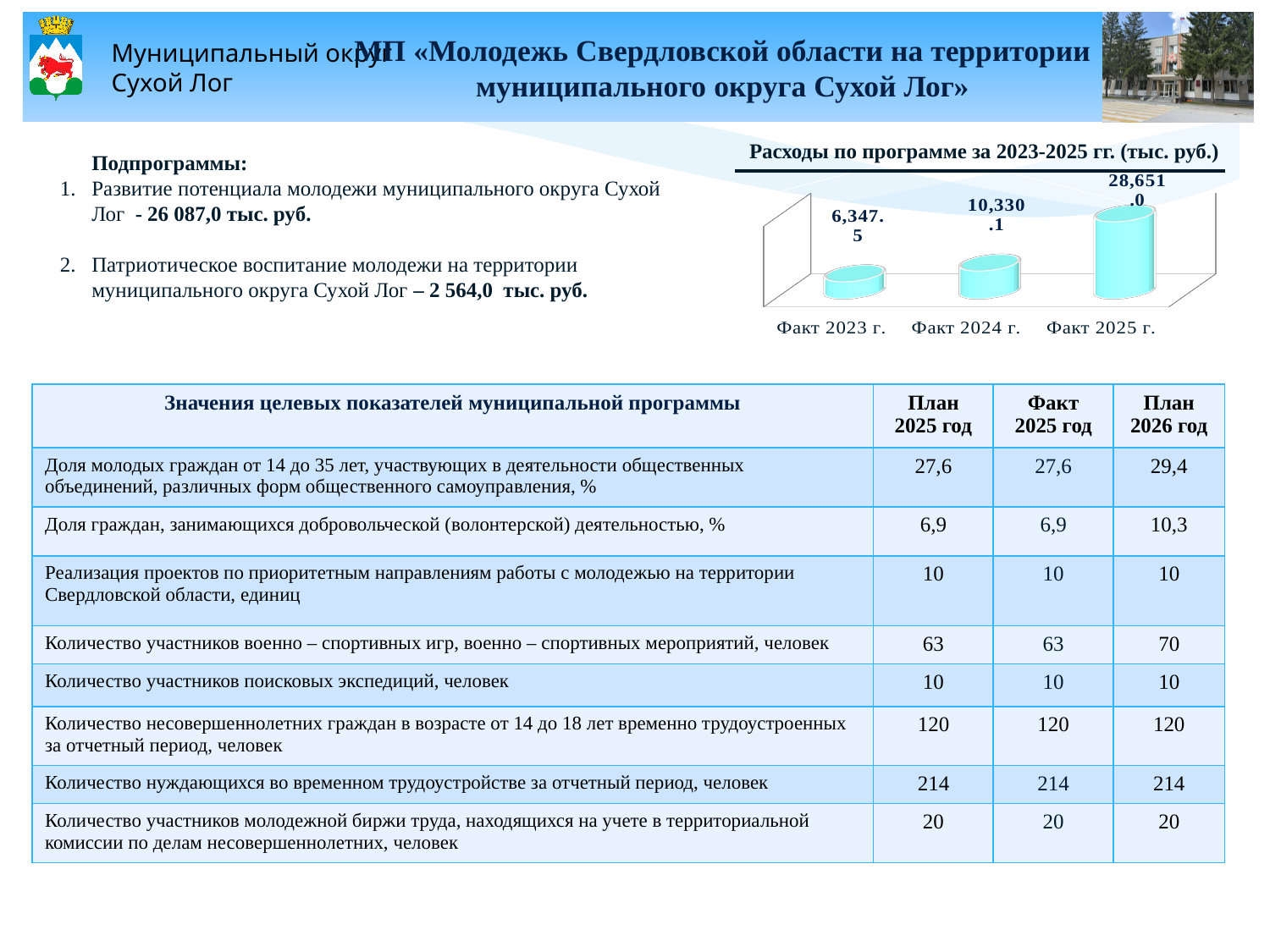
Which category has the lowest value in the chart? Факт 2023 г. What is the title of the chart? Расходы по программе за 2023-2025 гг. (тыс. руб.) What is the value for Факт 2024 г. in the chart? 10,330.1 What is the value for Факт 2025 г. in the chart? 28,651.0 What is the value for Факт 2023 г. in the chart? 6,347.5 What is the difference between the values for Факт 2024 г. and Факт 2023 г.? 3,982.6 What kind of chart is shown on the slide? bar chart What is the difference between the values for Факт 2025 г. and Факт 2024 г.? 18,320.9 Do the values rise or fall from Факт 2023 г. to Факт 2025 г.? rise Which category has the highest value in the chart? Факт 2025 г. Which is larger, the value for Факт 2024 г. or the value for Факт 2023 г.? Факт 2024 г. How many categories are shown in the chart? 3